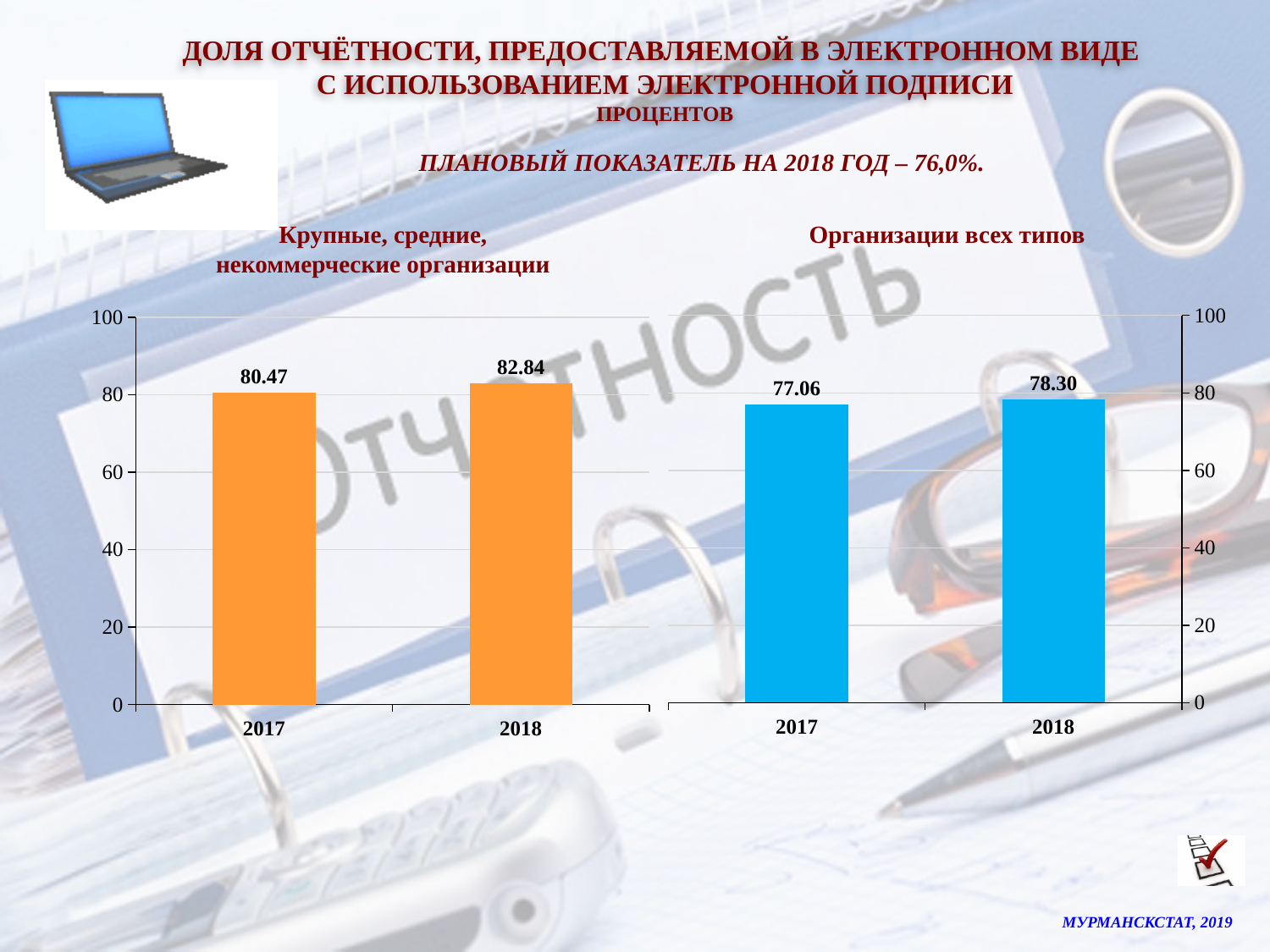
In the left chart (Крупные, средние, некоммерческие организации), what is the difference between the 2018 and 2017 values? 2.37 Which is larger: the 2018 value in the left chart (Крупные, средние, некоммерческие организации) or the 2018 value in the right chart (Организации всех типов)? The left chart's 2018 value (82.84) How many bars are plotted in the left chart (Крупные, средние, некоммерческие организации)? 2 In the right chart (Организации всех типов), do the values rise or fall from 2017 to 2018? rise What type of chart is used on this slide? bar chart In the right chart (Организации всех типов), what is the difference between the 2018 and 2017 values? 1.24 In the right chart (Организации всех типов), which year has the lower value? 2017 In the left chart (Крупные, средние, некоммерческие организации), what is the value for 2017? 80.47 In the right chart (Организации всех типов), what is the value for 2018? 78.30 In the right chart (Организации всех типов), what is the value for 2017? 77.06 In the left chart (Крупные, средние, некоммерческие организации), what is the value for 2018? 82.84 In the left chart (Крупные, средние, некоммерческие организации), which year has the higher value? 2018